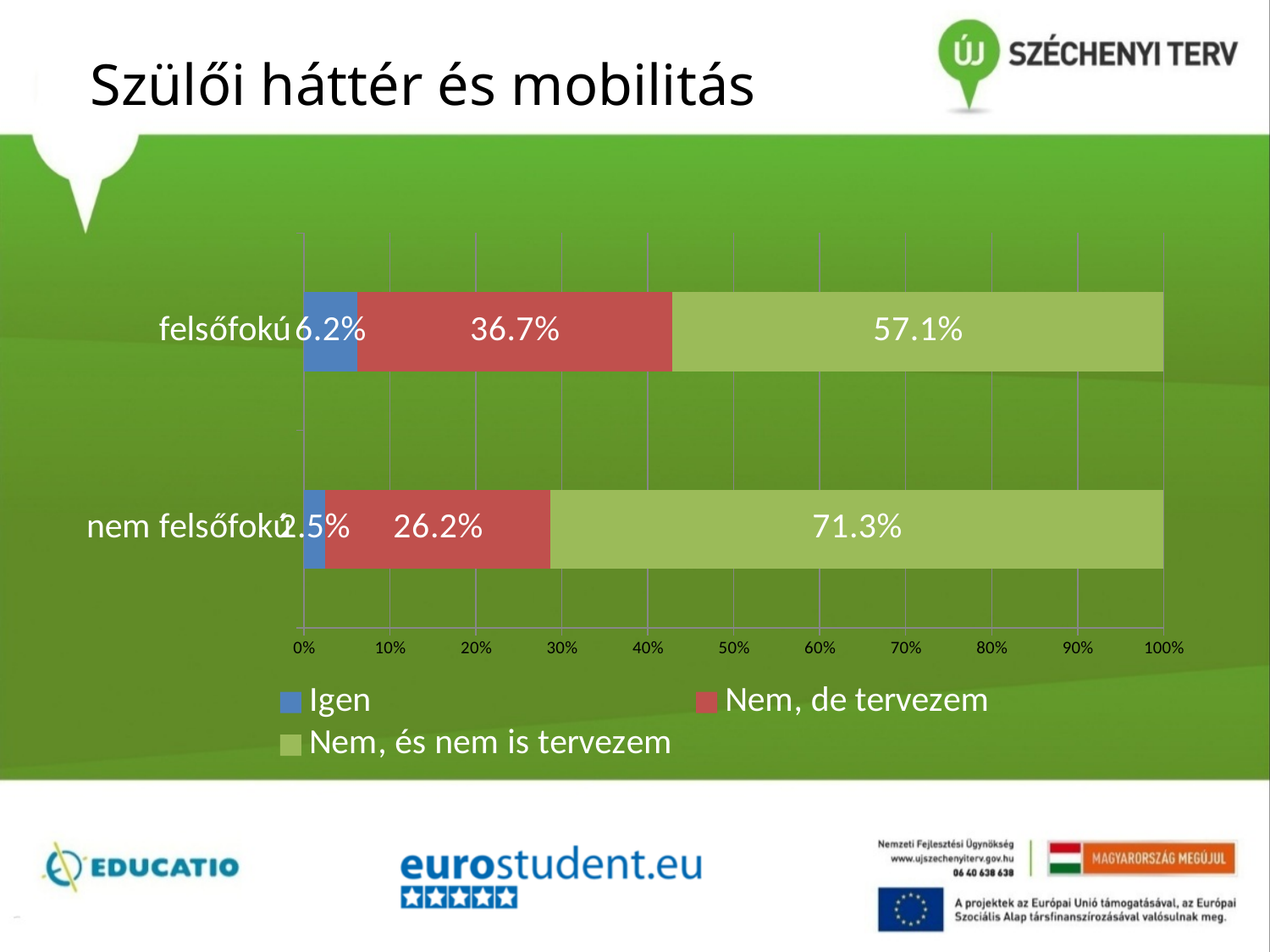
Which series is shown in blue in the legend? Igen How many series does the legend list? 3 What is the value of 'Nem, és nem is tervezem' for the 'felsőfokú' category? 57.1% Is the 'Igen' value for 'nem felsőfokú' greater or less than 10%? less Which category has the higher value for 'Nem, és nem is tervezem'? nem felsőfokú What is the value of 'Nem, de tervezem' for the 'felsőfokú' category? 36.7% What is the difference between the 'Nem, de tervezem' values for 'felsőfokú' and 'nem felsőfokú'? 10.5% What is the value of 'Igen' for the 'felsőfokú' category? 6.2% What is the value of 'Nem, de tervezem' for the 'nem felsőfokú' category? 26.2% How many categories are shown on the chart? 2 What is the value of 'Nem, és nem is tervezem' for the 'nem felsőfokú' category? 71.3% What kind of chart is shown on the slide? stacked bar chart